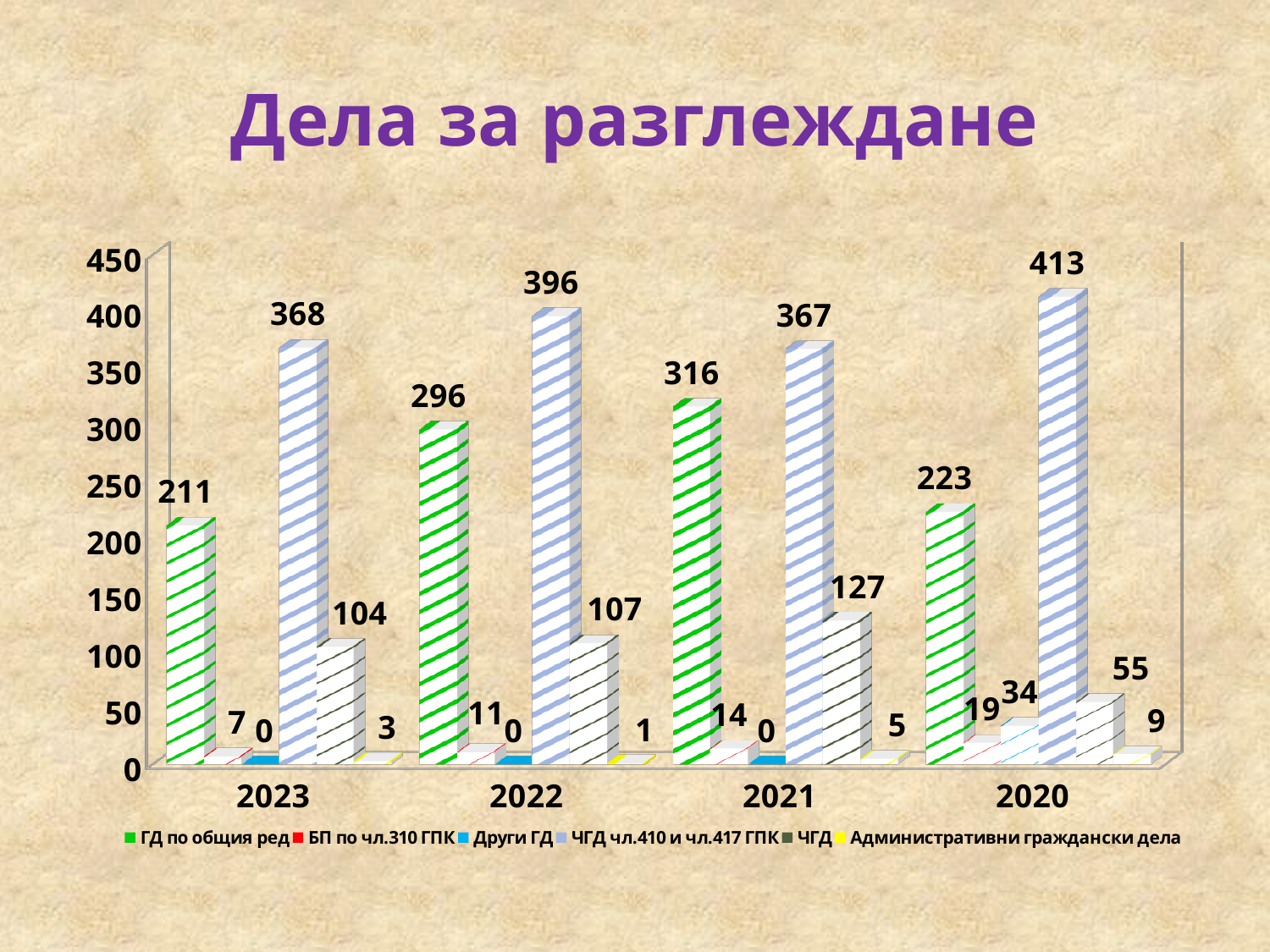
What is the value for Други ГД in 2020? 34 What is the value for ГД по общия ред in 2023? 211 What is the value for ЧГД чл.410 и чл.417 ГПК in 2020? 413 How many years are shown on the x axis? 4 In which year is the value for ЧГД чл.410 и чл.417 ГПК highest? 2020 In which year is the value for ГД по общия ред lowest? 2023 What kind of chart is shown on the slide? bar chart What is the difference between the ЧГД чл.410 и чл.417 ГПК values for 2022 and 2023? 28 Which is larger: ГД по общия ред in 2021 or ГД по общия ред in 2022? 2021 What is the value for ЧГД in 2021? 127 How many series does the legend list? 6 What is the title of the chart? Дела за разглеждане